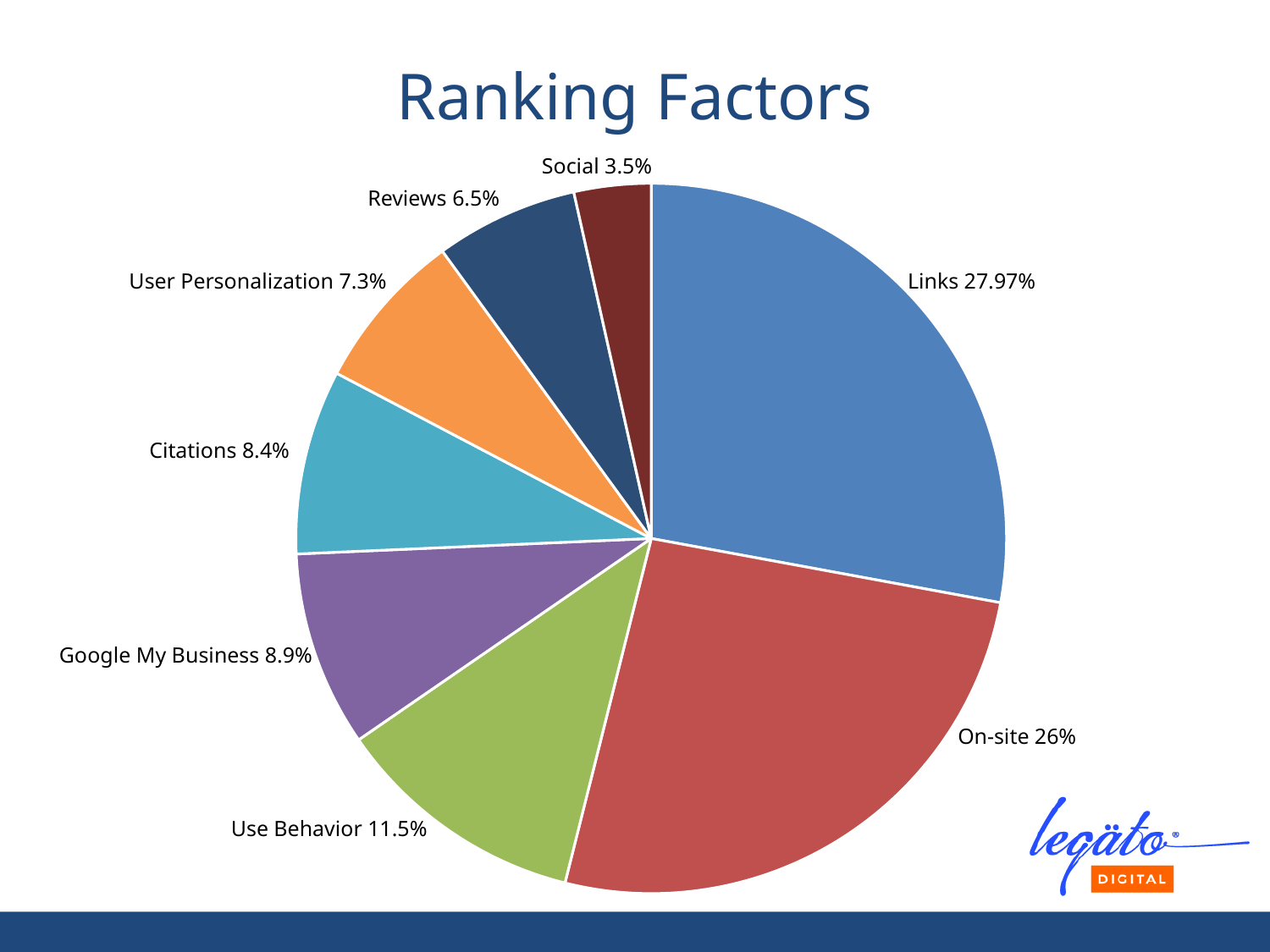
What is the value shown for Citations? 8.4% What is the value shown for Use Behavior? 11.5% Which category has the smallest slice of the pie? Social What is the difference between the Use Behavior and Citations values? 3.1% How many slices does the pie chart have? 8 What is the difference between the Reviews and Social values? 3% What share of the pie does Links account for? 27.97% What is the value shown for On-site? 26% What kind of chart is shown on the slide? pie chart What is the title of the chart? Ranking Factors Which is larger, Google My Business or User Personalization? Google My Business Which category has the largest slice of the pie? Links